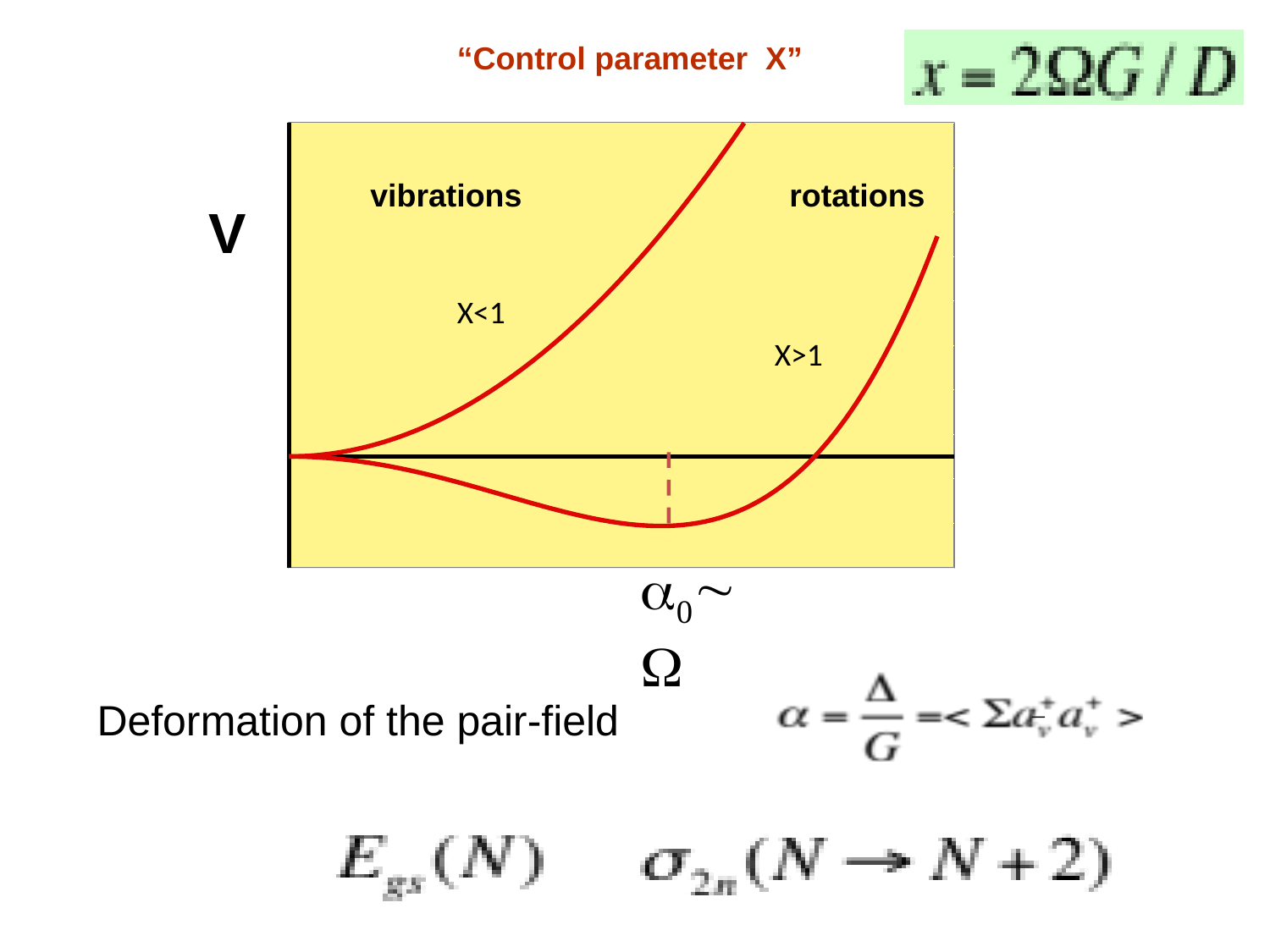
At the position of the dashed vertical line, which curve has the larger value of V, the X<1 curve or the X>1 curve? X<1 curve Which regime label is attached to the curve marked X<1? vibrations How many red curves are plotted in the chart? 2 Does the X<1 (vibrations) curve rise or fall as one moves to the right along the x axis? rise Which regime label is attached to the curve marked X>1? rotations What kind of chart is shown on the slide? line chart Which of the two curves dips below the horizontal axis? X>1 (rotations) curve